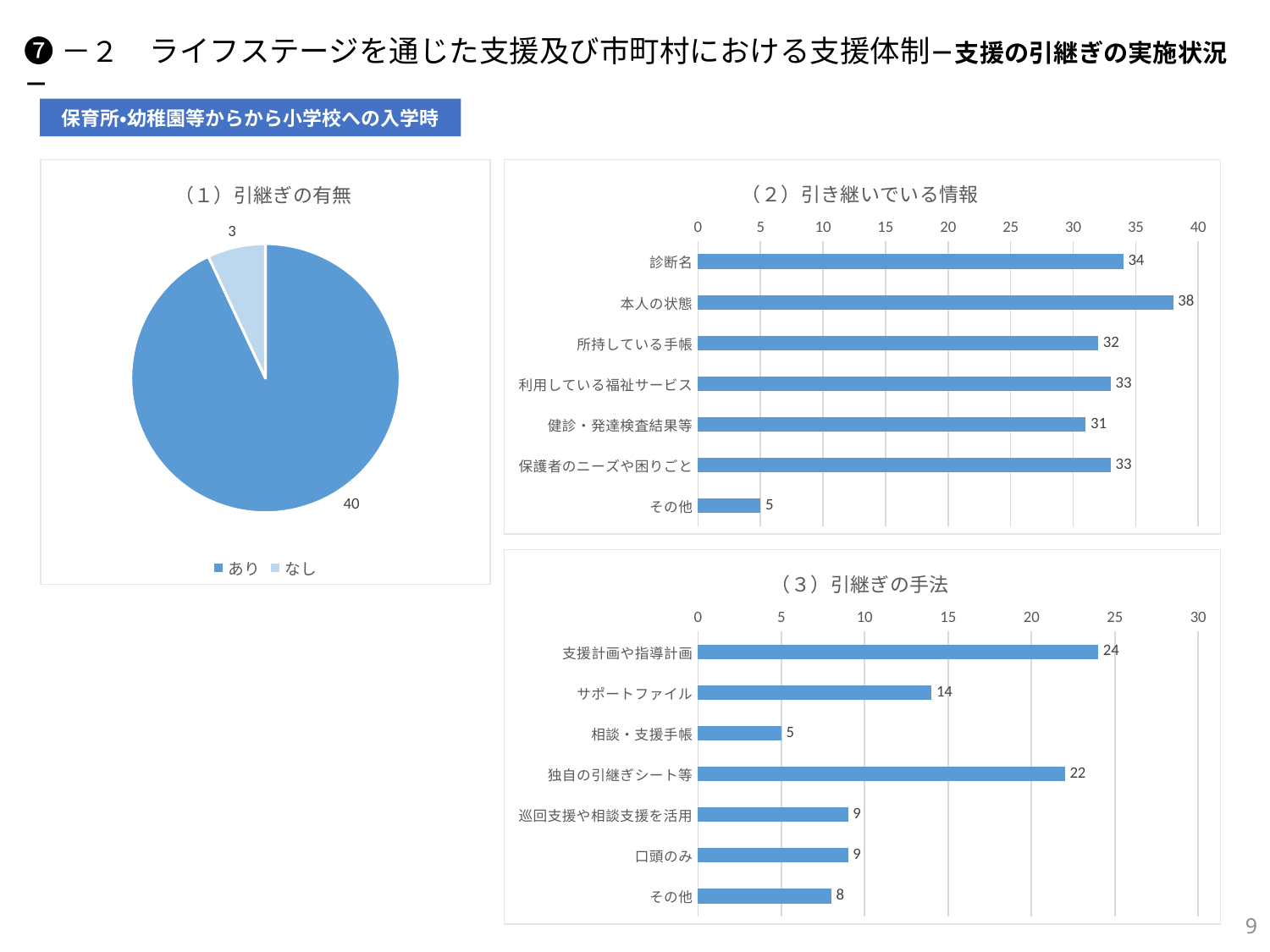
In the chart titled （３）引継ぎの手法, what is the value for サポートファイル? 14 In the chart titled （３）引継ぎの手法, which category has the highest value? 支援計画や指導計画 In the chart titled （２）引き継いでいる情報, which category has the lowest value? その他 In the chart titled （１）引継ぎの有無, how many entries does the legend list? 2 In the chart titled （２）引き継いでいる情報, what is the difference between 本人の状態 and 診断名? 4 In the chart titled （１）引継ぎの有無, what kind of chart is shown? pie chart In the chart titled （３）引継ぎの手法, which is larger, 独自の引継ぎシート等 or サポートファイル? 独自の引継ぎシート等 In the chart titled （１）引継ぎの有無, what is the value for あり? 40 In the chart titled （３）引継ぎの手法, what is the difference between 支援計画や指導計画 and 相談・支援手帳? 19 In the chart titled （２）引き継いでいる情報, what is the value for 本人の状態? 38 In the chart titled （２）引き継いでいる情報, how many categories are plotted? 7 In the chart titled （３）引継ぎの手法, what kind of chart is shown? bar chart